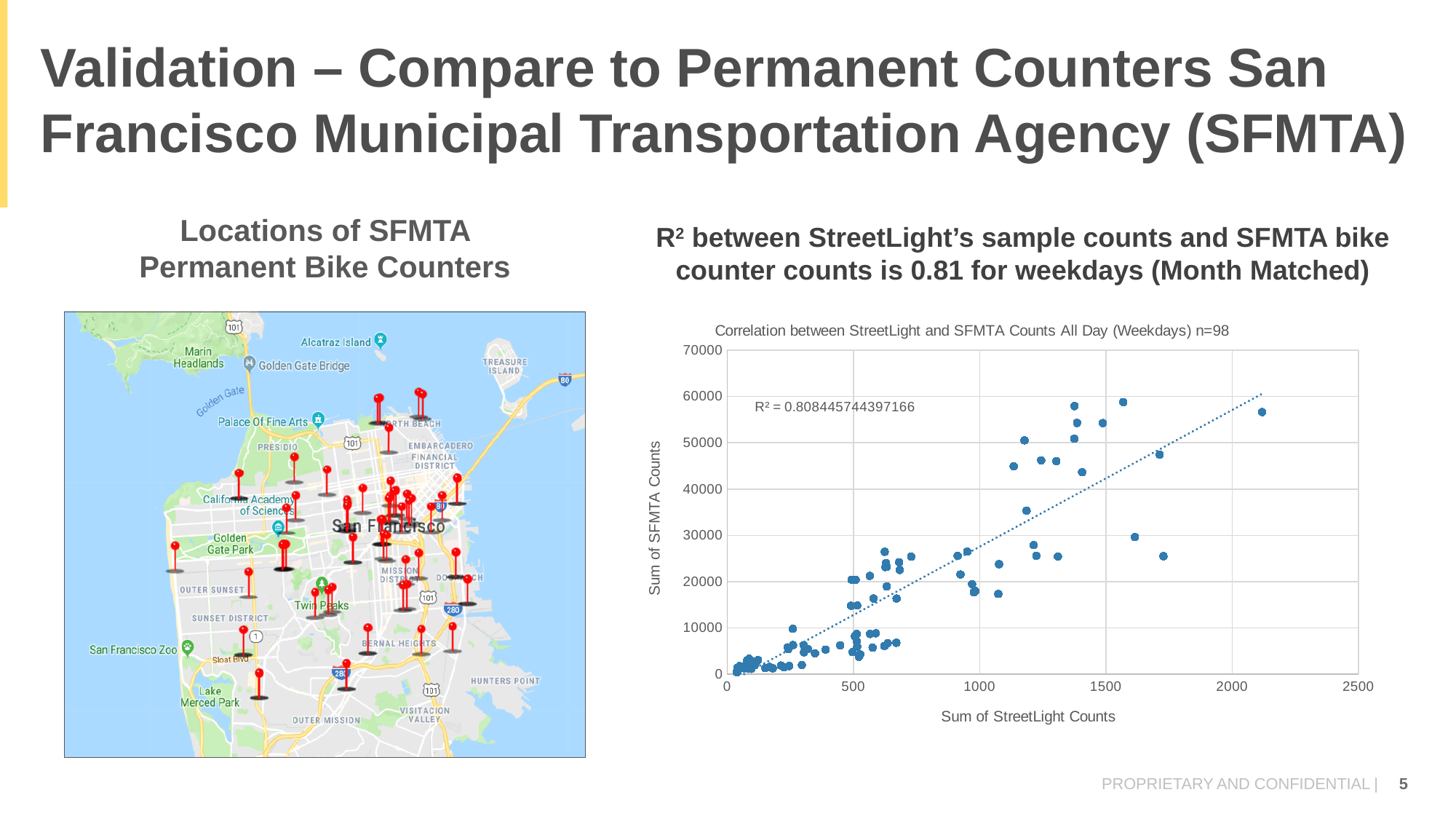
What R² value is printed inside the scatter chart? R² = 0.808445744397166 Is the largest Sum of StreetLight Counts value plotted greater or less than 2000? greater Is the largest Sum of SFMTA Counts value plotted greater or less than 60000? less According to the text above the scatter chart, what is the R² between StreetLight's sample counts and SFMTA bike counter counts for weekdays? 0.81 Do the SFMTA counts generally rise or fall as the StreetLight counts increase along the x axis? Rise What kind of chart is shown on the right side of the slide? Scatter chart What is the title of the scatter chart? Correlation between StreetLight and SFMTA Counts All Day (Weekdays) n=98 How many data points (n) does the scatter chart title say are plotted? 98 What is the label of the x axis of the scatter chart? Sum of StreetLight Counts What is the highest value shown on the x axis of the scatter chart? 2500 What is the highest value shown on the y axis of the scatter chart? 70000